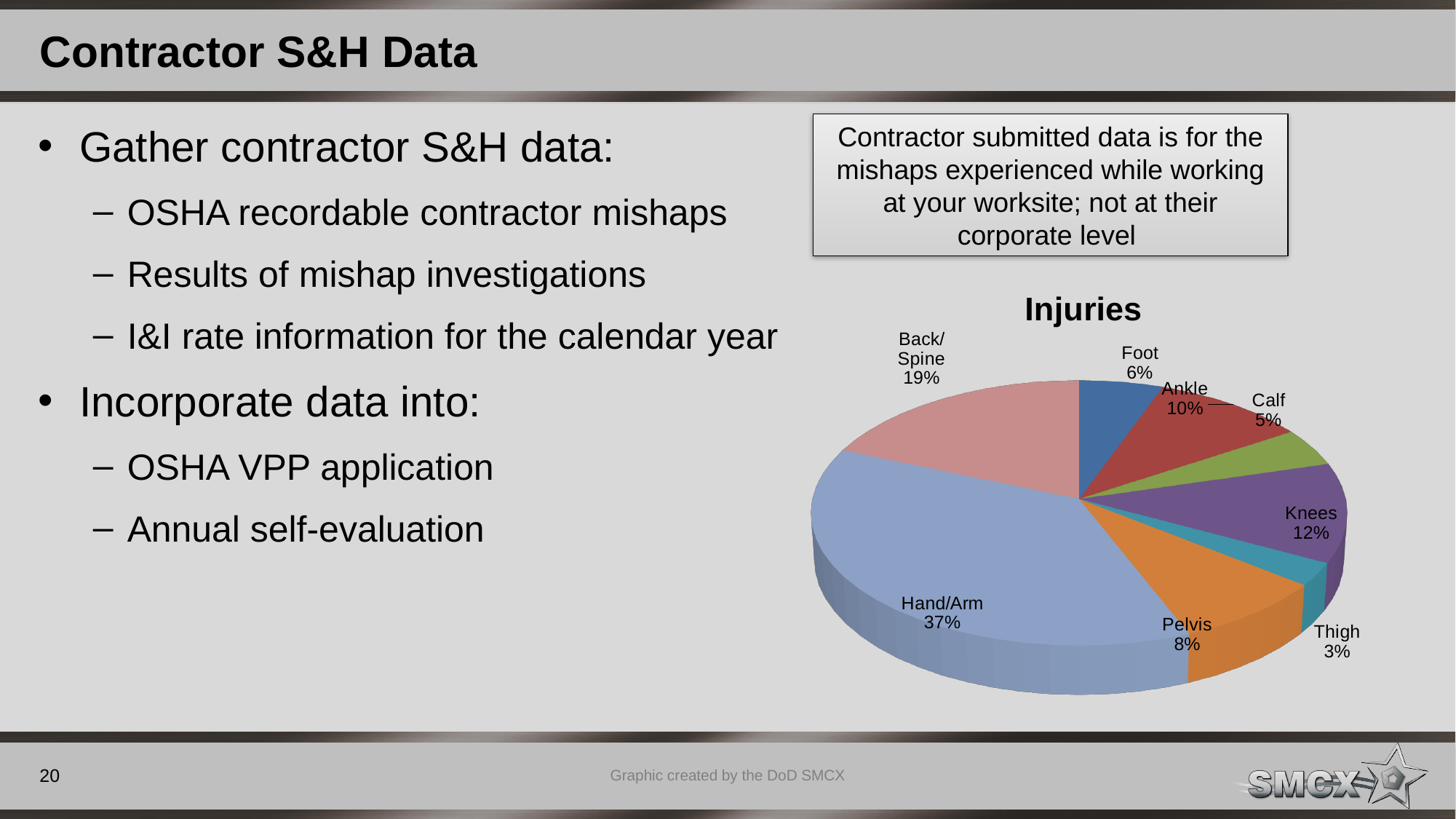
What is the value shown for Foot in the Injuries chart? 6% What is the title of the pie chart on the slide? Injuries What is the value shown for Knees in the Injuries chart? 12% How many injury categories are shown in the Injuries pie chart? 8 What type of chart is used to show the Injuries data? Pie chart Which injury category has the smallest slice in the Injuries chart? Thigh Which is larger in the Injuries chart, Ankle or Pelvis? Ankle What percentage does the Back/Spine slice represent in the Injuries chart? 19% What is the difference in percentage points between Knees and Calf in the Injuries chart? 7 What share of injuries is Hand/Arm in the Injuries pie chart? 37% Which injury category has the largest slice in the Injuries chart? Hand/Arm What is the difference in percentage points between Hand/Arm and Back/Spine in the Injuries chart? 18